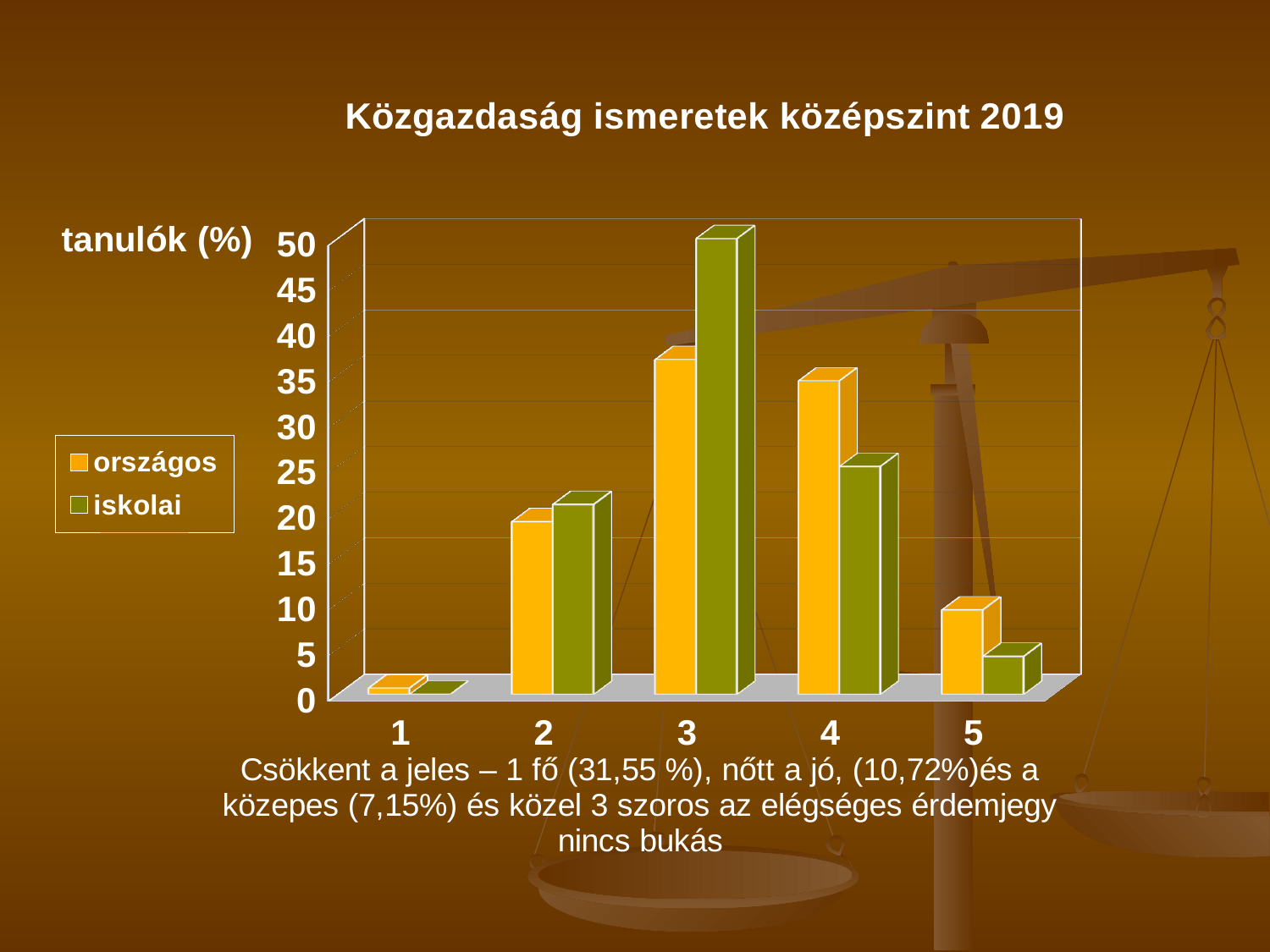
Which category has the lowest value for the iskolai series? 1 How many categories are shown on the x axis? 5 Is the iskolai value for category 5 greater or less than 10? less How many series does the legend list? 2 Which category has the highest value for the országos series? 3 For category 3, which series has the larger value, országos or iskolai? iskolai Is the iskolai value for category 3 greater or less than 45? greater What is the label on the vertical axis of the chart? tanulók (%) Which category has the lowest value for the országos series? 1 What kind of chart is shown on the slide? bar chart Which category has the highest value for the iskolai series? 3 For category 4, which series has the larger value, országos or iskolai? országos